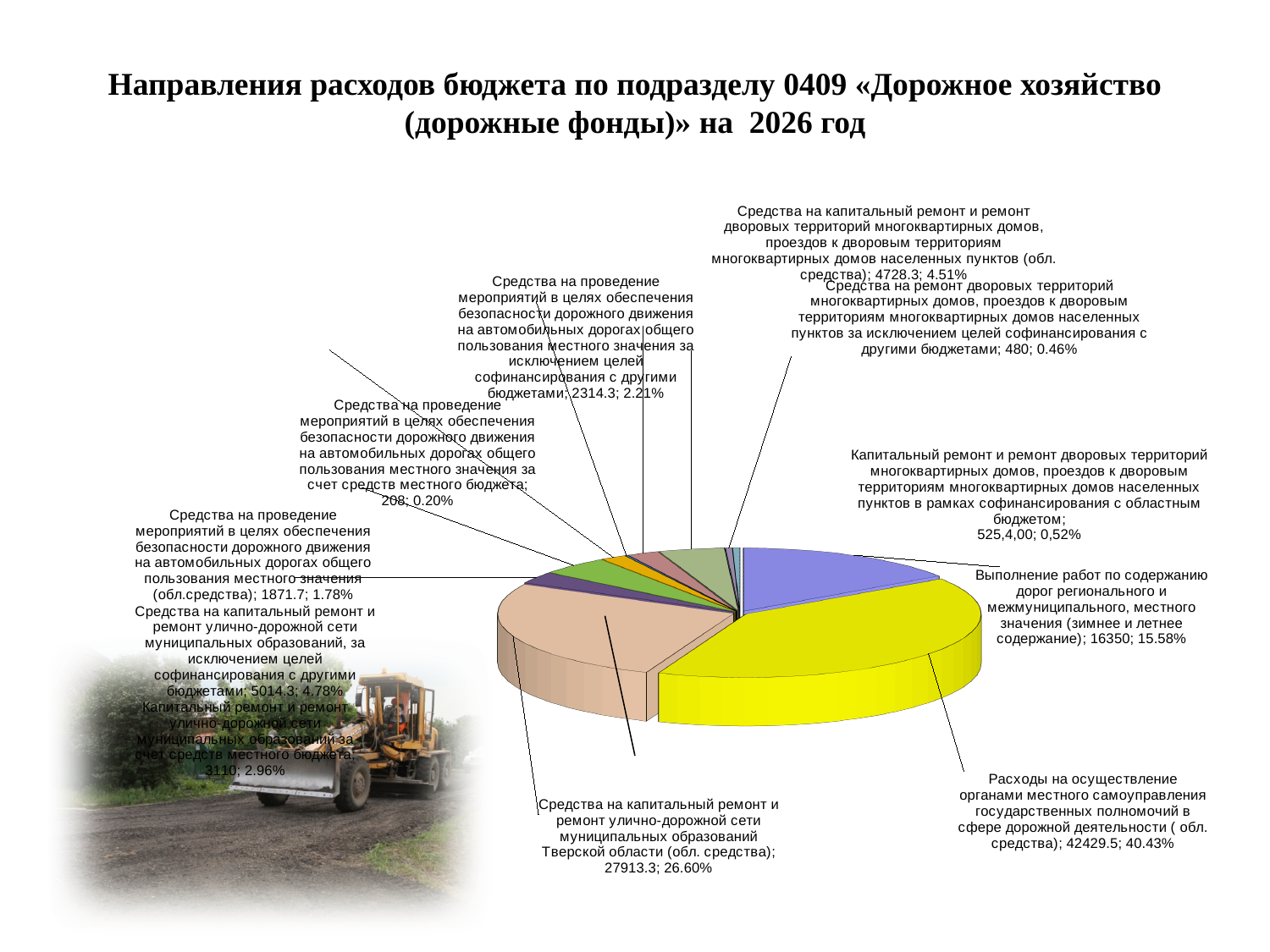
Which is larger: the value for «Расходы на осуществление органами местного самоуправления государственных полномочий в сфере дорожной деятельности (обл. средства)» or for «Средства на капитальный ремонт и ремонт улично-дорожной сети муниципальных образований Тверской области (обл. средства)»? Расходы на осуществление органами местного самоуправления государственных полномочий в сфере дорожной деятельности (обл. средства) What value is shown for «Капитальный ремонт и ремонт улично-дорожной сети муниципальных образований за счет средств местного бюджета»? 3110 What percentage share is shown for «Средства на ремонт дворовых территорий многоквартирных домов, проездов к дворовым территориям многоквартирных домов населенных пунктов за исключением целей софинансирования с другими бюджетами»? 0.46% Which category has the largest share of the pie? Расходы на осуществление органами местного самоуправления государственных полномочий в сфере дорожной деятельности (обл. средства) For which year does the slide title say the budget expenditure directions are shown? 2026 What value is shown for «Выполнение работ по содержанию дорог регионального и межмуниципального, местного значения (зимнее и летнее содержание)»? 16350 What is the difference between the value for «Выполнение работ по содержанию дорог регионального и межмуниципального, местного значения (зимнее и летнее содержание)» (16350) and «Капитальный ремонт и ремонт улично-дорожной сети муниципальных образований за счет средств местного бюджета» (3110)? 13240 Which category has the smallest share of the pie? Средства на проведение мероприятий в целях обеспечения безопасности дорожного движения на автомобильных дорогах общего пользования местного значения за счет средств местного бюджета What value is shown for «Средства на капитальный ремонт и ремонт дворовых территорий многоквартирных домов, проездов к дворовым территориям многоквартирных домов населенных пунктов (обл. средства)»? 4728.3 What kind of chart is shown on the slide? pie chart How many slices does the pie chart have? 11 What percentage share is shown for «Средства на капитальный ремонт и ремонт улично-дорожной сети муниципальных образований Тверской области (обл. средства)»? 26.60%